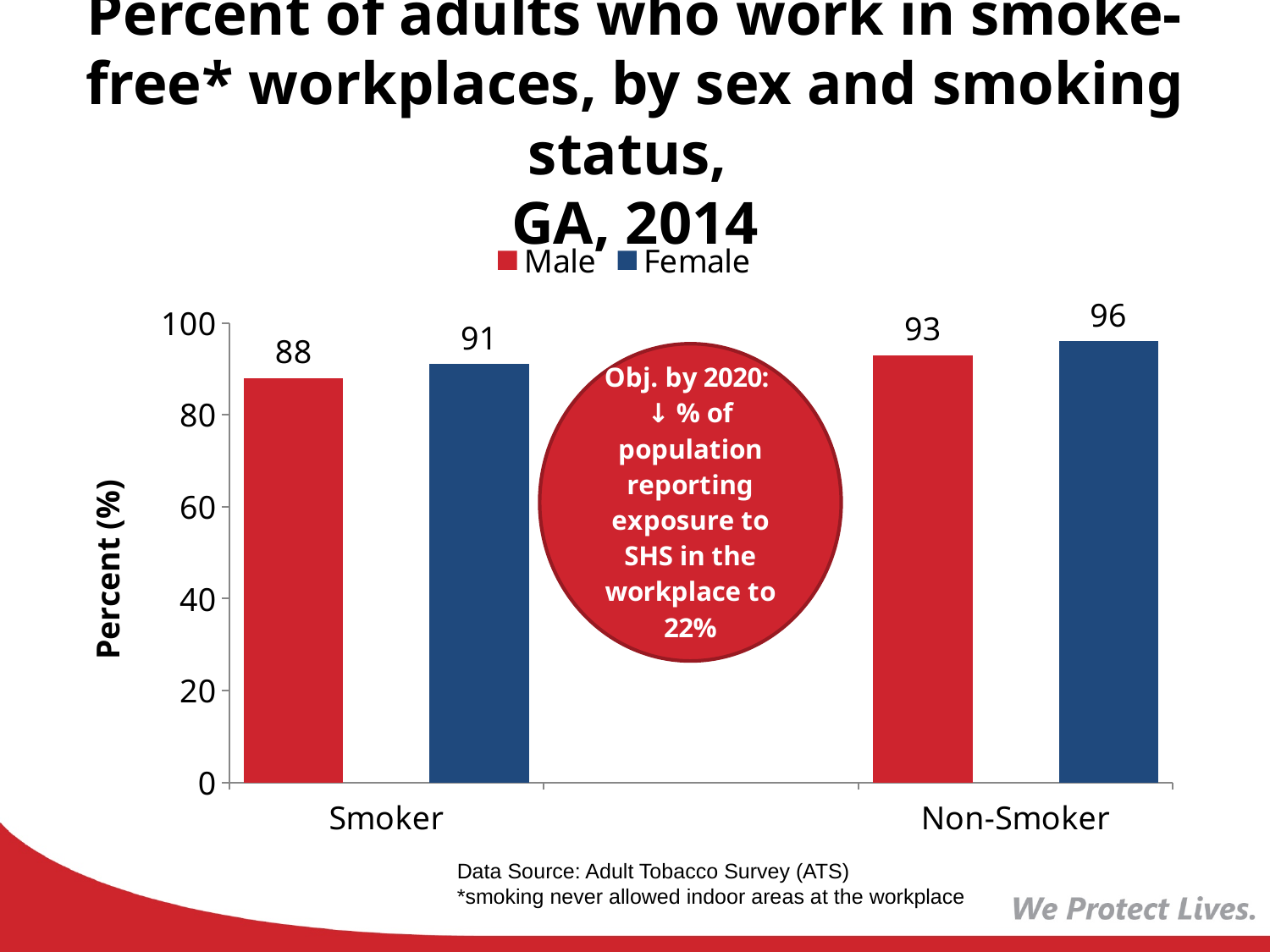
What is the label of the y axis? Percent (%) How many series does the legend list? 2 What is the difference between the Female and Male values in the Non-Smoker category? 3 What is the difference between the Male values for Non-Smoker and Smoker? 5 What kind of chart is shown on the slide? Bar chart Which is larger: the Female value for Smoker or the Male value for Non-Smoker? Male value for Non-Smoker Which bar has the highest value on the chart? Female, Non-Smoker Which bar has the lowest value on the chart? Male, Smoker What is the value for Male in the Non-Smoker category? 93 What is the value for Male in the Smoker category? 88 What is the value for Female in the Smoker category? 91 What is the value for Female in the Non-Smoker category? 96